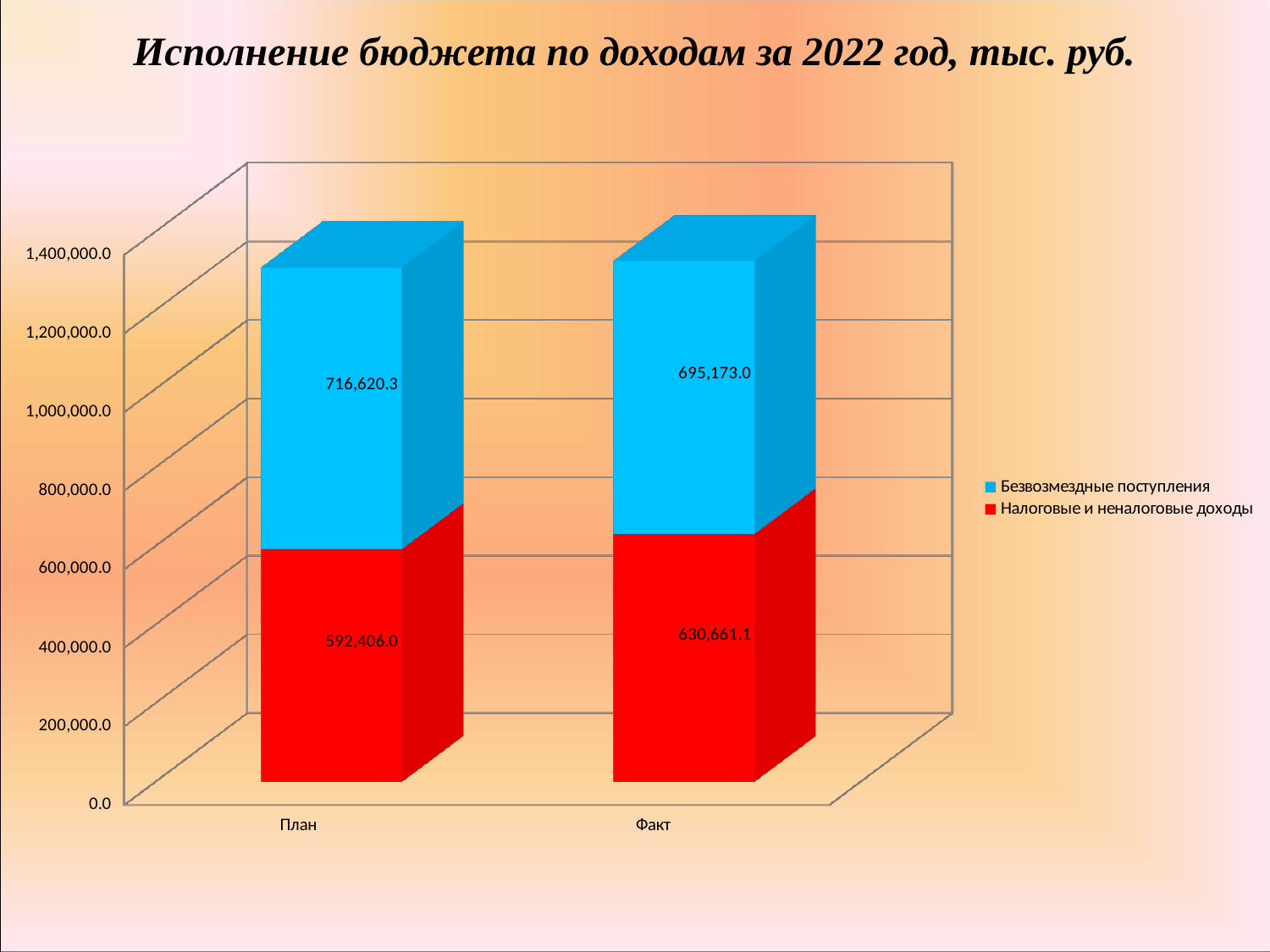
What is the difference between the План and Факт values for Безвозмездные поступления? 21,447.3 What is the value of Безвозмездные поступления for Факт? 695,173.0 Which category has the higher value for Безвозмездные поступления, План or Факт? План Which category has the higher value for Налоговые и неналоговые доходы, План or Факт? Факт What is the value of Безвозмездные поступления for План? 716,620.3 What is the difference between the Факт and План values for Налоговые и неналоговые доходы? 38,255.1 What is the total of the stacked bar for Факт? 1,325,834.1 What is the value of Налоговые и неналоговые доходы for Факт? 630,661.1 How many series does the legend list? 2 What is the total of the stacked bar for План? 1,309,026.3 What is the value of Налоговые и неналоговые доходы for План? 592,406.0 What kind of chart is shown on the slide? Stacked bar chart